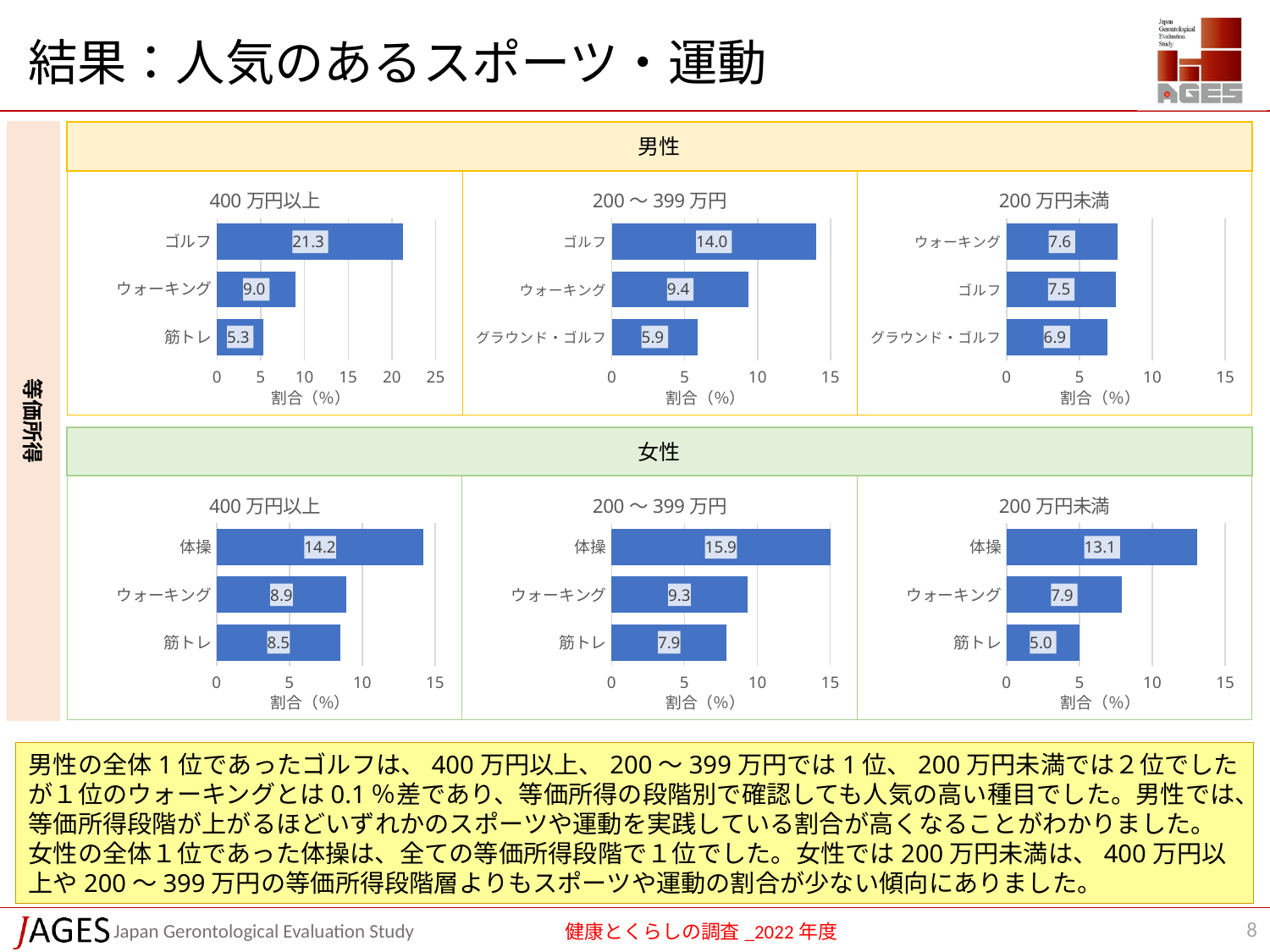
女性・400万円以上のグラフで、ウォーキングと筋トレではどちらの値が大きいですか？ ウォーキング 男性・400万円以上のグラフで、ゴルフの値はいくつですか？ 21.3 男性・200〜399万円のグラフには、いくつの項目（棒）がありますか？ 3 女性・200万円未満のグラフで、体操とウォーキングの値の差はいくつですか？ 5.2 男性・400万円以上のグラフで、ゴルフとウォーキングの値の差はいくつですか？ 12.3 男性・200〜399万円のグラフで、ウォーキングの値はいくつですか？ 9.4 女性・200〜399万円のグラフで、体操の値は15より大きいですか、小さいですか？ 大きい 男性・200万円未満のグラフで、最も値が小さい項目はどれですか？ グラウンド・ゴルフ 女性・200万円未満のグラフはどの種類のグラフですか？ 棒グラフ 女性・200万円未満のグラフで、筋トレの値はいくつですか？ 5.0 各グラフの横軸のラベルは何ですか？ 割合（%） 女性・200〜399万円のグラフで、最も値が大きい項目はどれですか？ 体操